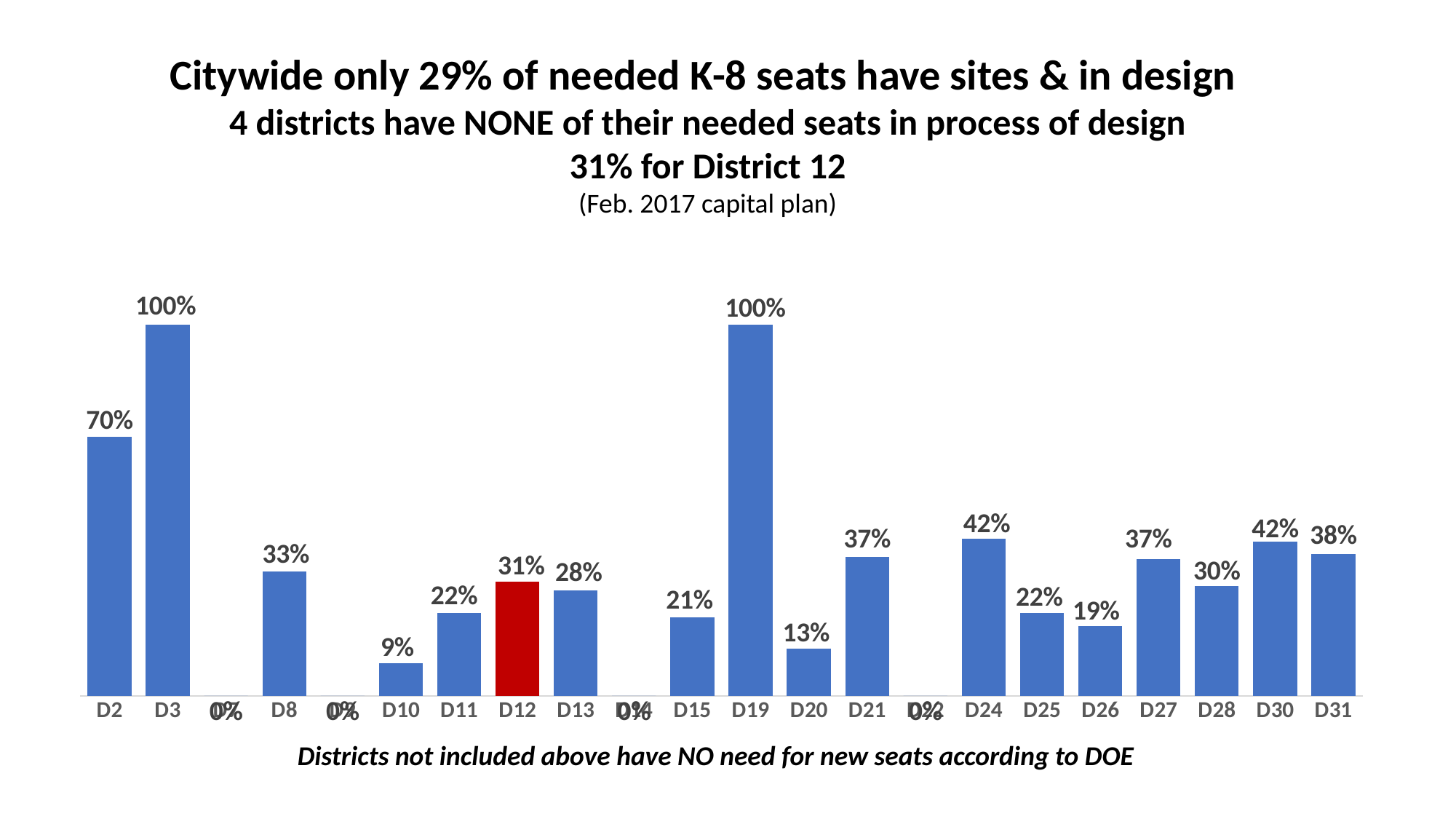
What is the difference between the values for D31 and D28? 8% Which district's bar is coloured red? D12 Which has a larger value, D13 or D11? D13 What is the value for D10? 9% What is the difference between the values for D3 and D2? 30% What is the value for D20? 13% What kind of chart is shown on the slide? bar chart How many districts (bars) are plotted on the chart? 22 What is the value for D2? 70% What is the value for D24? 42% What is the value for D12? 31% Which has a larger value, D21 or D20? D21